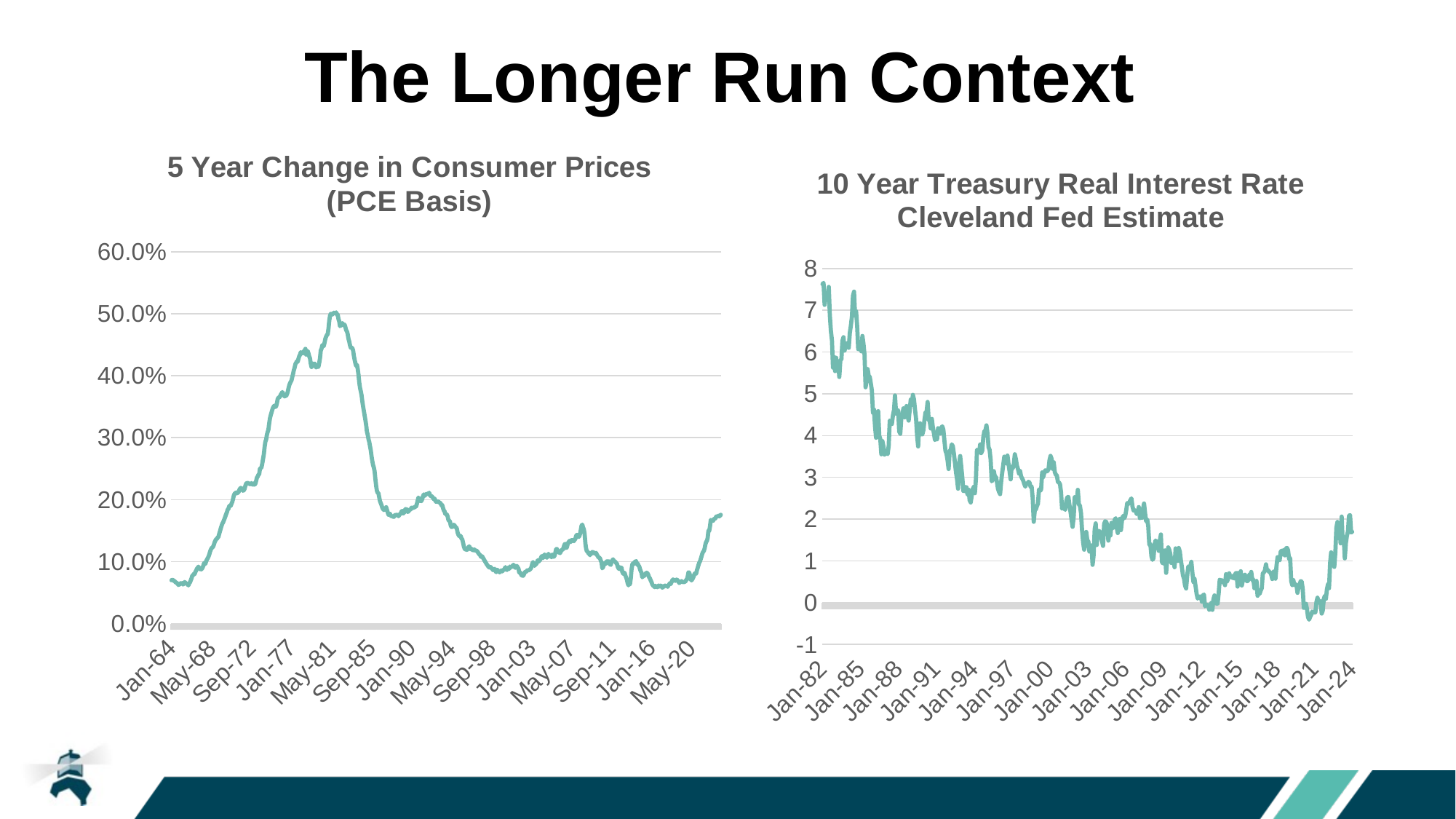
What is the highest value shown on the vertical axis of the '10 Year Treasury Real Interest Rate Cleveland Fed Estimate' chart? 8 In the '5 Year Change in Consumer Prices (PCE Basis)' chart, is the value at Jan-16 greater or less than 10.0%? less In the '5 Year Change in Consumer Prices (PCE Basis)' chart, is the value at Sep-85 greater or less than 30.0%? less In the '5 Year Change in Consumer Prices (PCE Basis)' chart, is the value at May-81 greater or less than 40.0%? greater In the '5 Year Change in Consumer Prices (PCE Basis)' chart, does the value rise or fall from Jan-64 to May-81? rise What kind of chart is the '5 Year Change in Consumer Prices (PCE Basis)' chart on the left? line chart What kind of chart is the '10 Year Treasury Real Interest Rate Cleveland Fed Estimate' chart on the right? line chart In the '10 Year Treasury Real Interest Rate Cleveland Fed Estimate' chart, does the real interest rate generally rise or fall from Jan-82 to Jan-21? fall